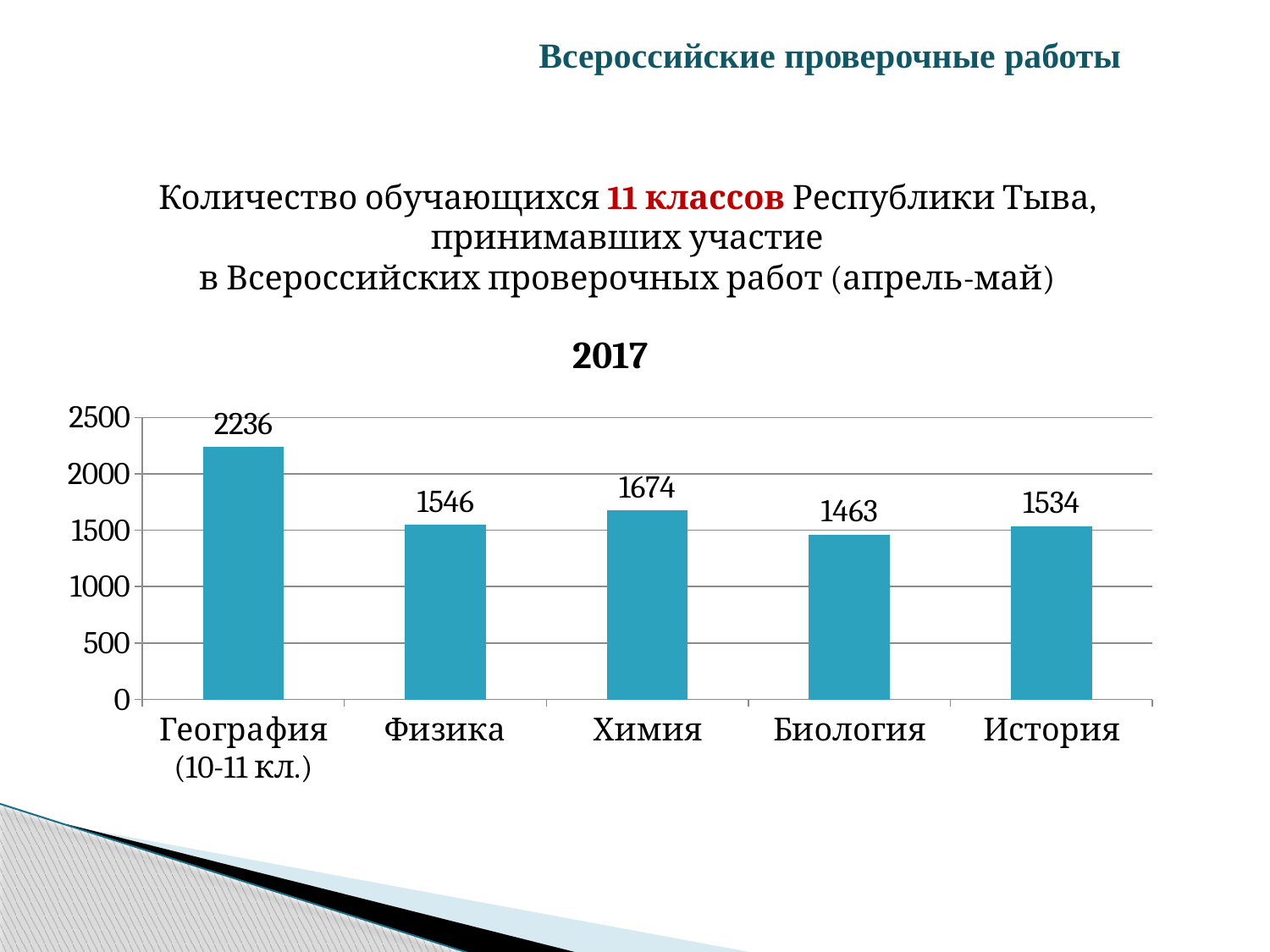
What is the value for География (10-11 кл.)? 2236 What is the difference between the values for География (10-11 кл.) and Физика? 690 What is the value for Биология? 1463 What is the title of the chart? 2017 Which is larger, the value for Физика or the value for История? Физика Which category has the lowest value? Биология What is the difference between the values for Химия and История? 140 Which category has the highest value? География (10-11 кл.) What kind of chart is shown on the slide? bar chart Is the value for Биология greater or less than 1500? less How many categories are shown on the x axis? 5 What is the value for Химия? 1674